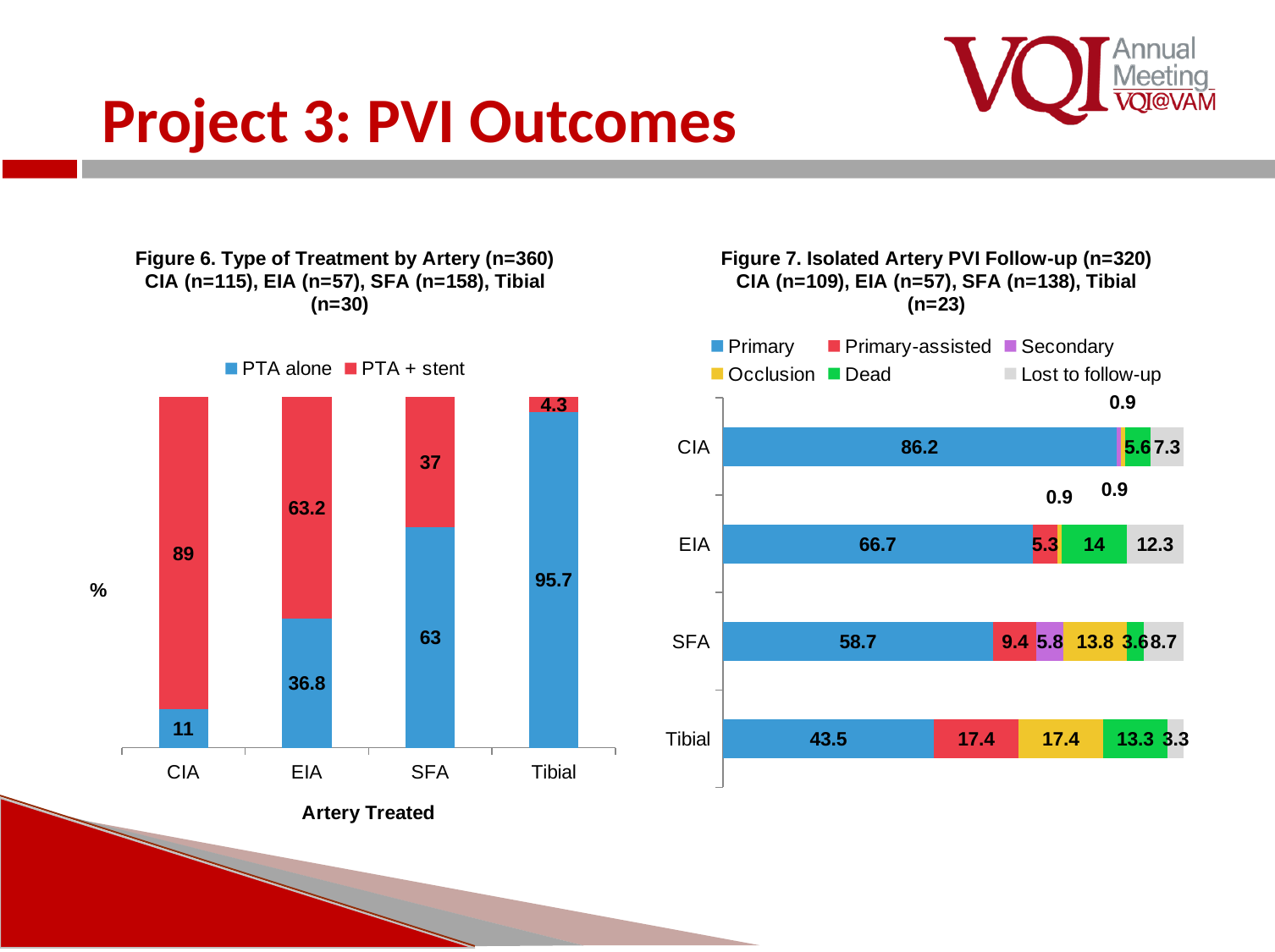
In Figure 7 (Isolated Artery PVI Follow-up), what is the Primary value for SFA? 58.7 What kind of chart is Figure 7 (Isolated Artery PVI Follow-up)? Stacked horizontal bar chart In Figure 7 (Isolated Artery PVI Follow-up), how many series does the legend list? 6 In Figure 6 (Type of Treatment by Artery), which artery has the highest PTA alone value? Tibial In Figure 7 (Isolated Artery PVI Follow-up), which artery has the lowest Primary value? Tibial In Figure 7 (Isolated Artery PVI Follow-up), what is the Lost to follow-up value for EIA? 12.3 In Figure 6 (Type of Treatment by Artery), what is the PTA + stent value for CIA? 89 In Figure 6 (Type of Treatment by Artery), what is the PTA alone value for EIA? 36.8 In Figure 6 (Type of Treatment by Artery), which artery has the lowest PTA + stent value? Tibial In Figure 6 (Type of Treatment by Artery), what is the difference between the PTA alone and PTA + stent values for SFA? 26 In Figure 7 (Isolated Artery PVI Follow-up), is the Dead value larger for EIA or for SFA? EIA In Figure 6 (Type of Treatment by Artery), how many series does the legend list? 2